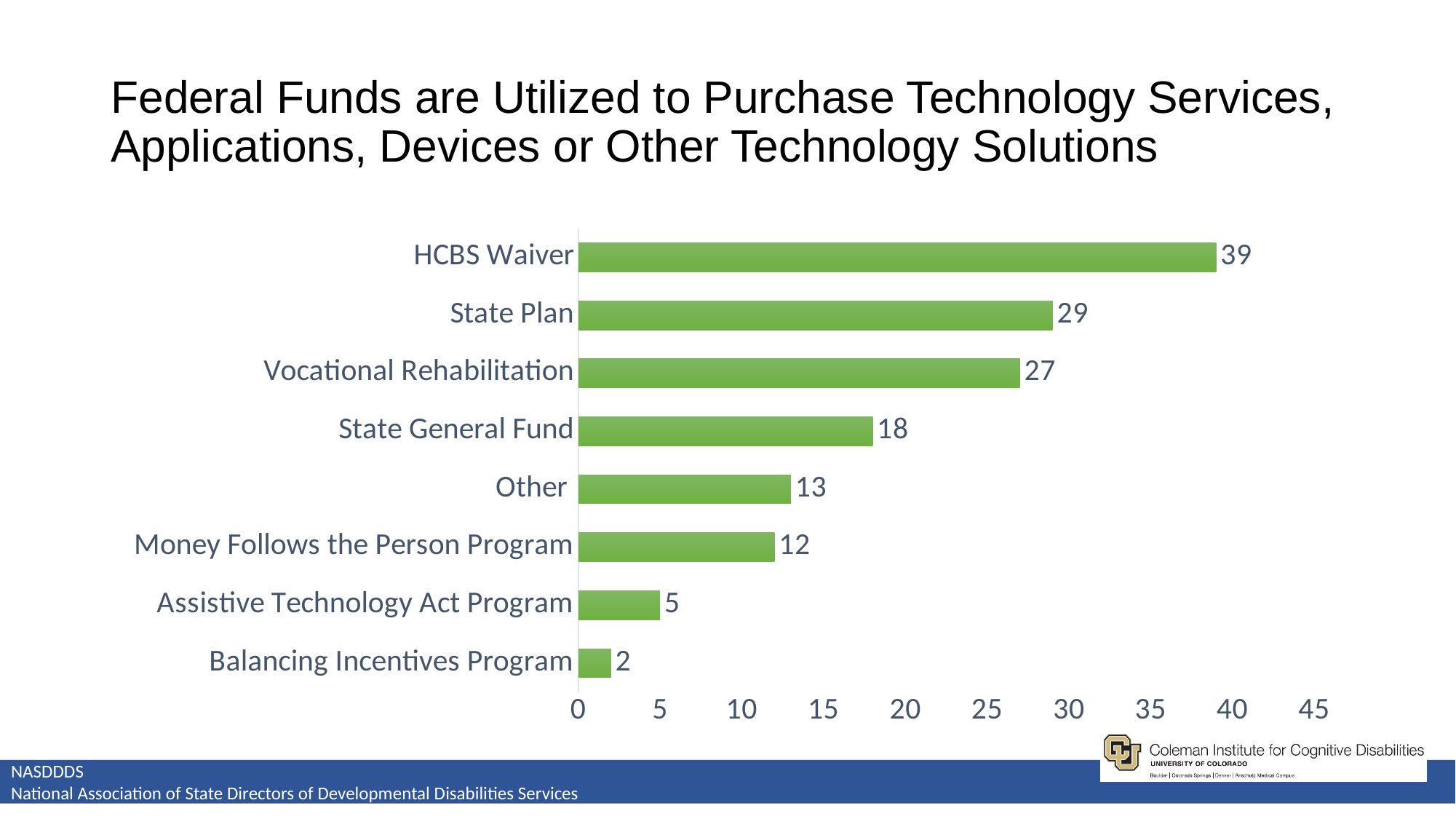
Which category has the lowest value? Balancing Incentives Program What is the difference between the values for HCBS Waiver and State Plan? 10 How many categories are shown in the chart? 8 What is the highest tick value shown on the horizontal axis? 45 What is the value for Vocational Rehabilitation? 27 Which is larger, the value for State Plan or the value for Vocational Rehabilitation? State Plan What is the value for Money Follows the Person Program? 12 What is the value for HCBS Waiver? 39 What kind of chart is shown on the slide? bar chart Is the value for State General Fund greater or less than 20? less What is the difference between the values for State General Fund and Other? 5 Which category has the highest value? HCBS Waiver